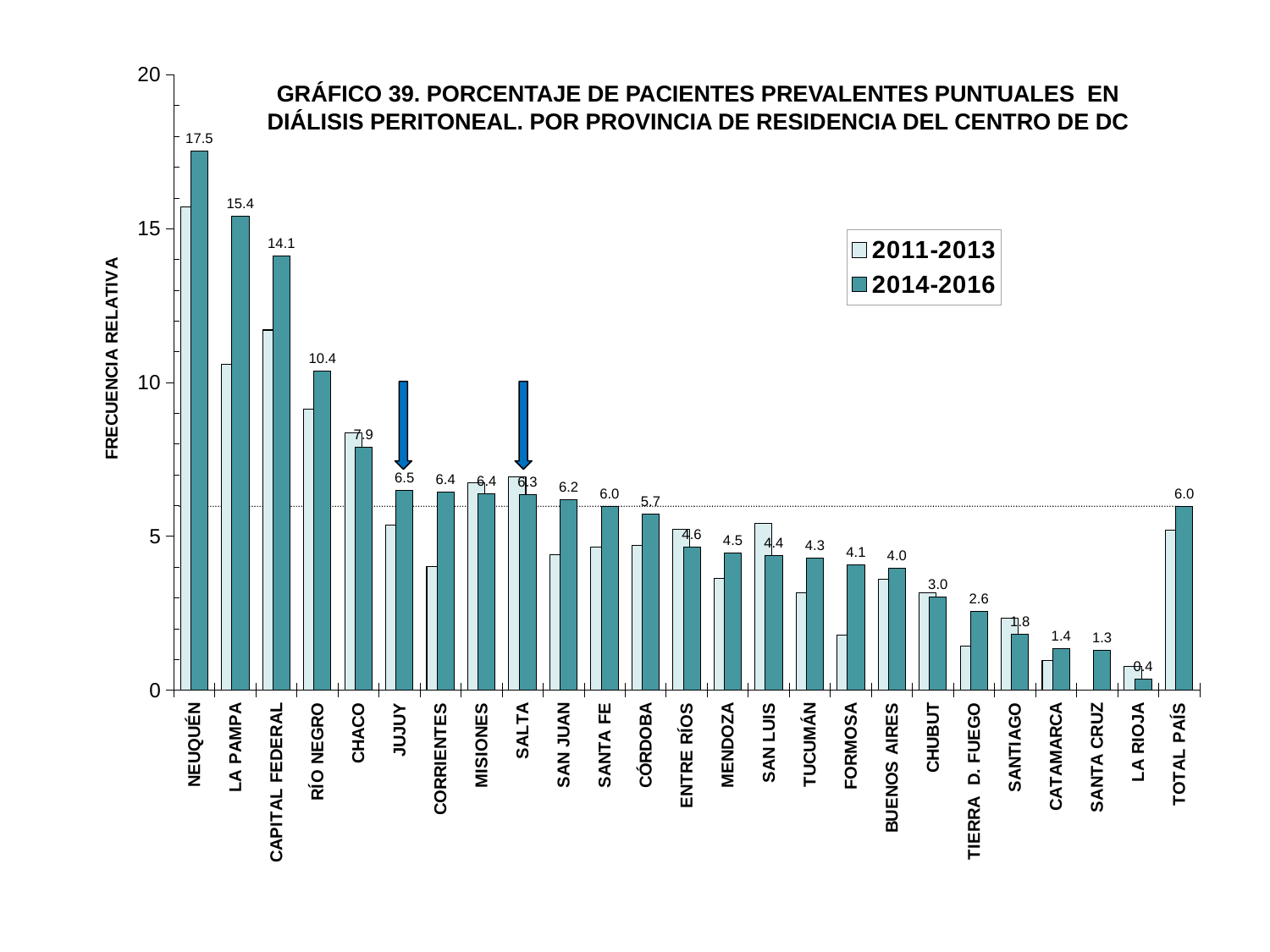
Is the 2011-2013 value for NEUQUÉN greater or less than 15? greater How many series does the legend list? 2 Which is larger in the 2014-2016 series, RÍO NEGRO or CHACO? RÍO NEGRO What kind of chart is shown on the slide? Bar chart Is the 2011-2013 value for CAPITAL FEDERAL greater or less than 10? greater Do the 2014-2016 values generally rise or fall from NEUQUÉN to LA RIOJA along the x axis? Fall What is the value for CHUBUT in the 2014-2016 series? 3.0 Which province has the lowest value in the 2014-2016 series? LA RIOJA Which province has the highest value in the 2014-2016 series? NEUQUÉN What is the value for NEUQUÉN in the 2014-2016 series? 17.5 What is the value for TOTAL PAÍS in the 2014-2016 series? 6.0 What is the difference between the 2014-2016 values for NEUQUÉN and LA PAMPA? 2.1